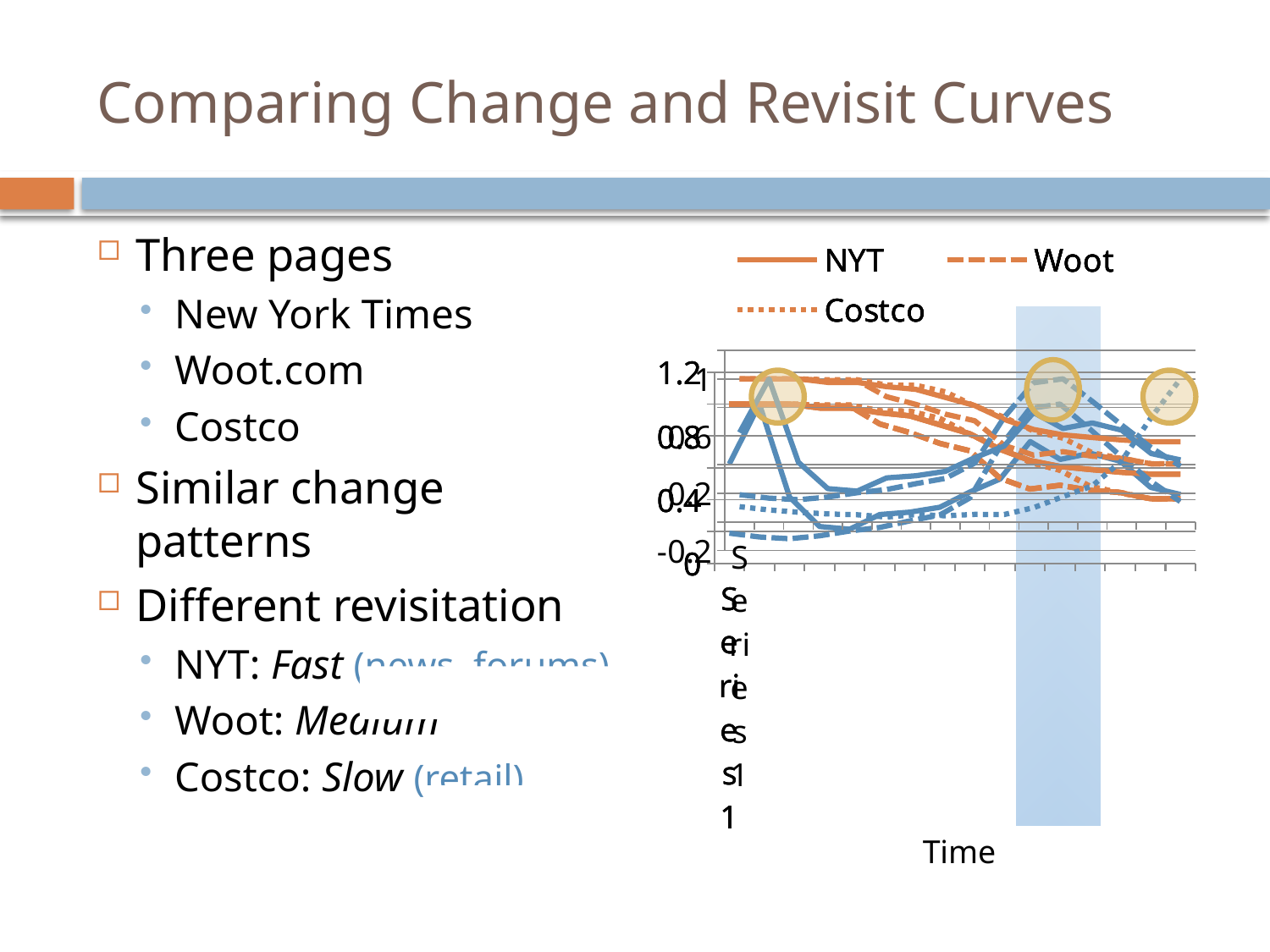
What kind of chart is shown on the slide? line chart What is the label on the chart's x axis? Time Which three series are listed in the chart's legend? NYT, Woot, Costco How many series does the chart's legend list? 3 Do the orange solid NYT line values generally rise or fall along the x axis? fall